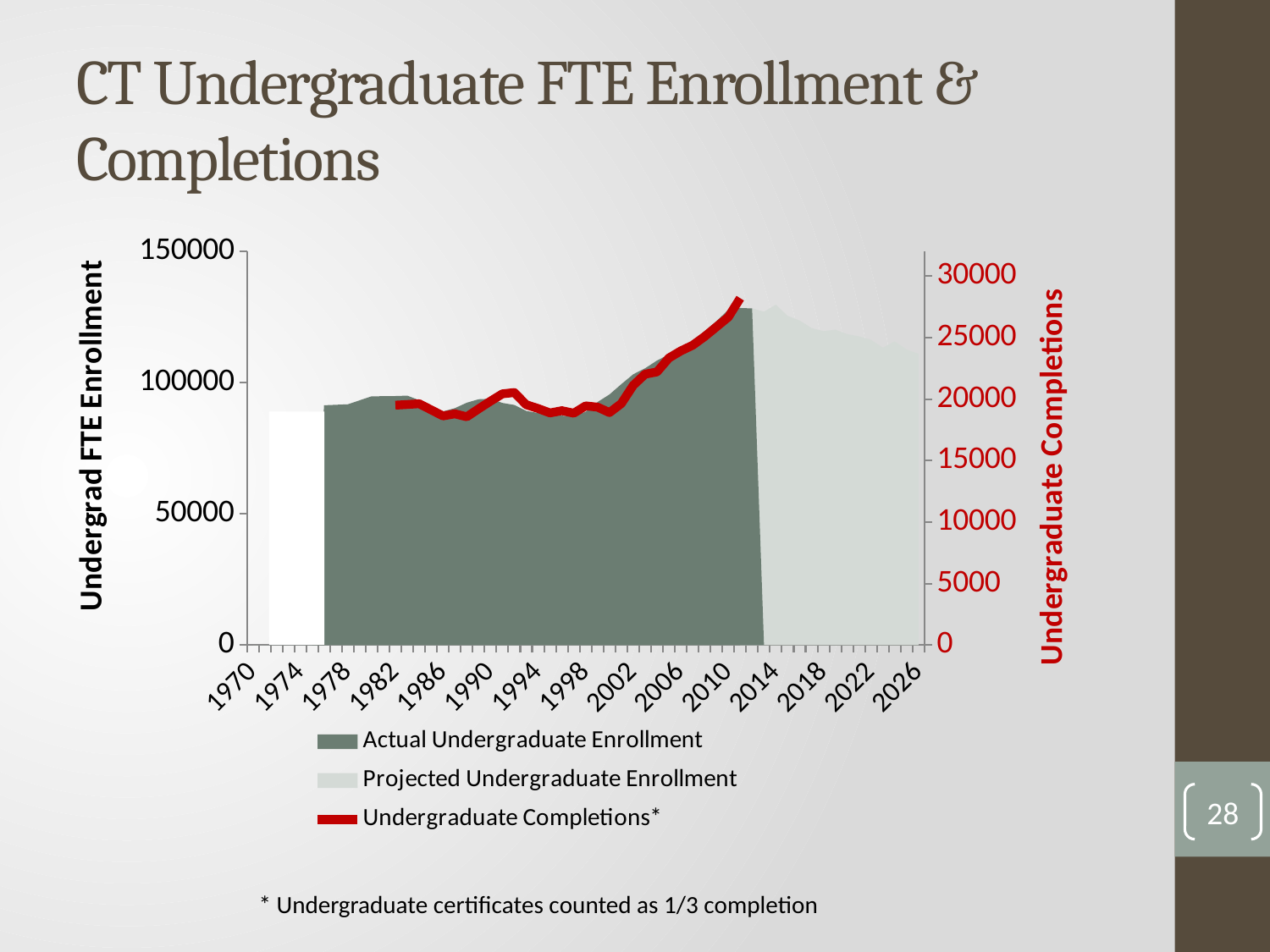
Is the Actual Undergraduate Enrollment value for 2010 greater or less than 100000? greater How many series does the chart legend list? 3 Is the Projected Undergraduate Enrollment value for 2026 greater or less than 100000? greater What is the title of the right-hand vertical axis? Undergraduate Completions Is the Actual Undergraduate Enrollment value for 1978 greater or less than 100000? less What kind of chart is used to show the Actual Undergraduate Enrollment series? area chart What kind of chart is used to show the Undergraduate Completions series? line chart What is the title of the chart on the slide? CT Undergraduate FTE Enrollment & Completions Do Undergraduate Completions rise or fall between 2002 and 2012? rise Does Projected Undergraduate Enrollment rise or fall between 2014 and 2026? fall